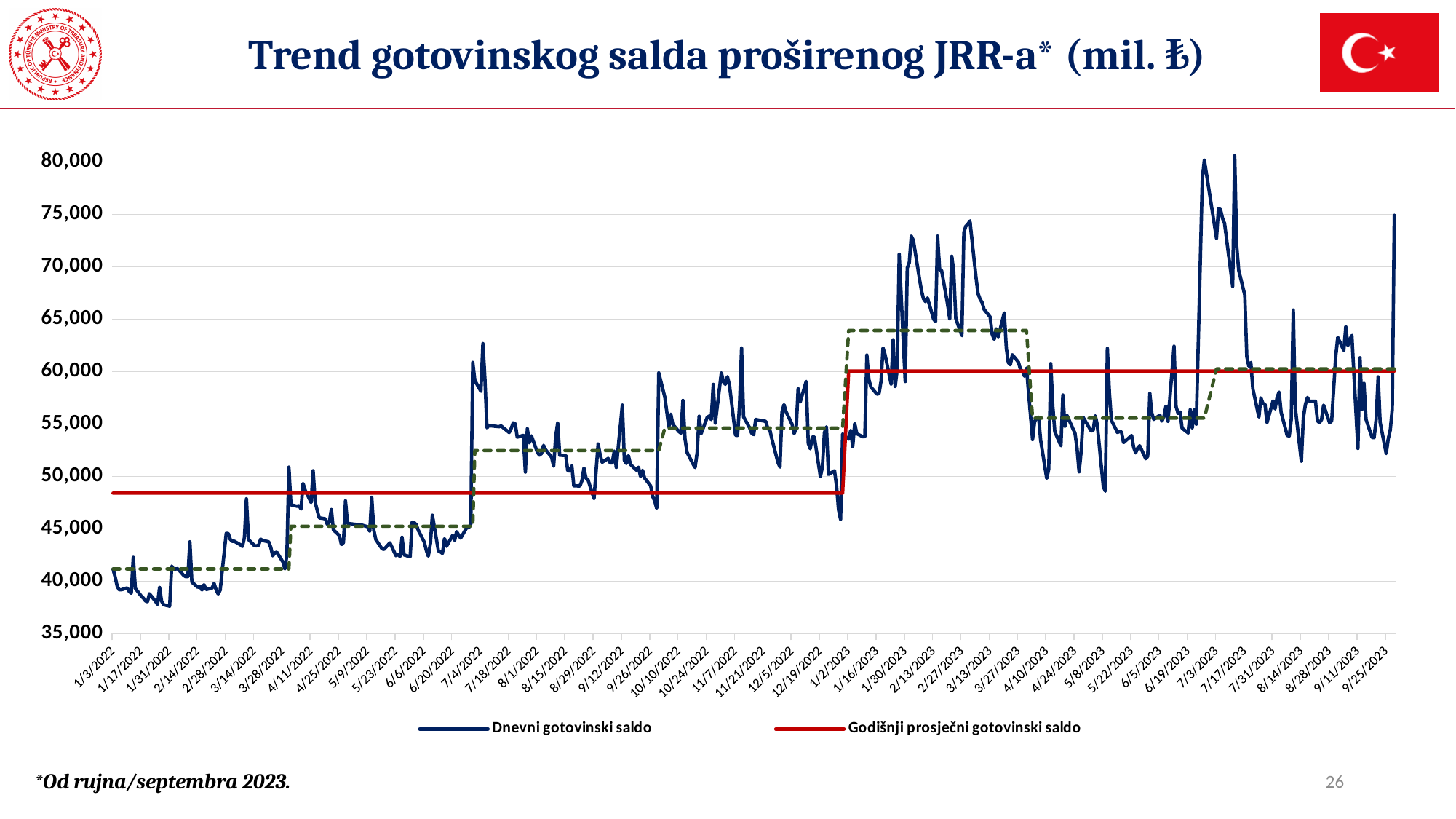
In which year does the 'Dnevni gotovinski saldo' reach its lowest point, 2022 or 2023? 2022 Is the 'Godišnji prosječni gotovinski saldo' value during 2023 greater or less than 55,000? greater Which is larger: the 'Godišnji prosječni gotovinski saldo' in 2022 or in 2023? 2023 Is the 'Godišnji prosječni gotovinski saldo' value during 2022 greater or less than 45,000? greater Which colour is used for the 'Dnevni gotovinski saldo' series? Dark blue How many series does the legend list? 2 What kind of chart is shown on the slide? Line chart What is the title of the chart? Trend gotovinskog salda proširenog JRR-a* (mil. ₺) Does the 'Godišnji prosječni gotovinski saldo' rise or fall from 2022 to 2023? Rise Is the 'Dnevni gotovinski saldo' value around 1/31/2022 greater or less than 40,000? less